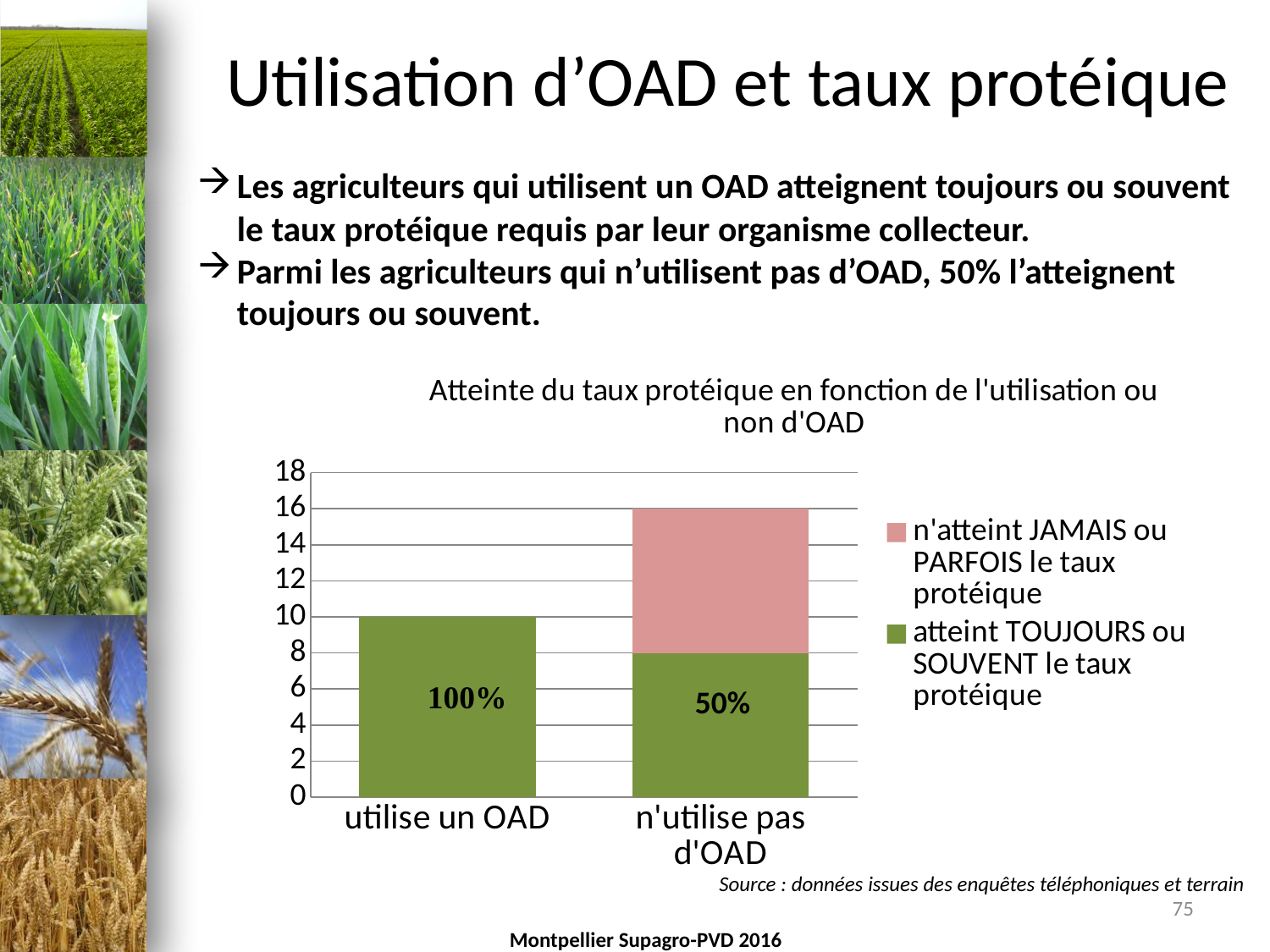
What is the value of 'atteint TOUJOURS ou SOUVENT le taux protéique' for 'n'utilise pas d'OAD'? 8 What percentage label is printed on the green segment of the 'n'utilise pas d'OAD' bar? 50% What percentage label is printed on the green segment of the 'utilise un OAD' bar? 100% Which colour represents 'n'atteint JAMAIS ou PARFOIS le taux protéique' in the chart? pink What kind of chart is shown on the slide? stacked bar chart What is the title of the chart? Atteinte du taux protéique en fonction de l'utilisation ou non d'OAD Is the total for 'n'utilise pas d'OAD' greater or less than 14? greater What is the value of 'atteint TOUJOURS ou SOUVENT le taux protéique' for 'utilise un OAD'? 10 How many categories are shown on the x axis of the chart? 2 How many series does the chart legend list? 2 Which category has the taller stacked bar overall? n'utilise pas d'OAD What is the total height of the stacked bar for 'n'utilise pas d'OAD'? 16